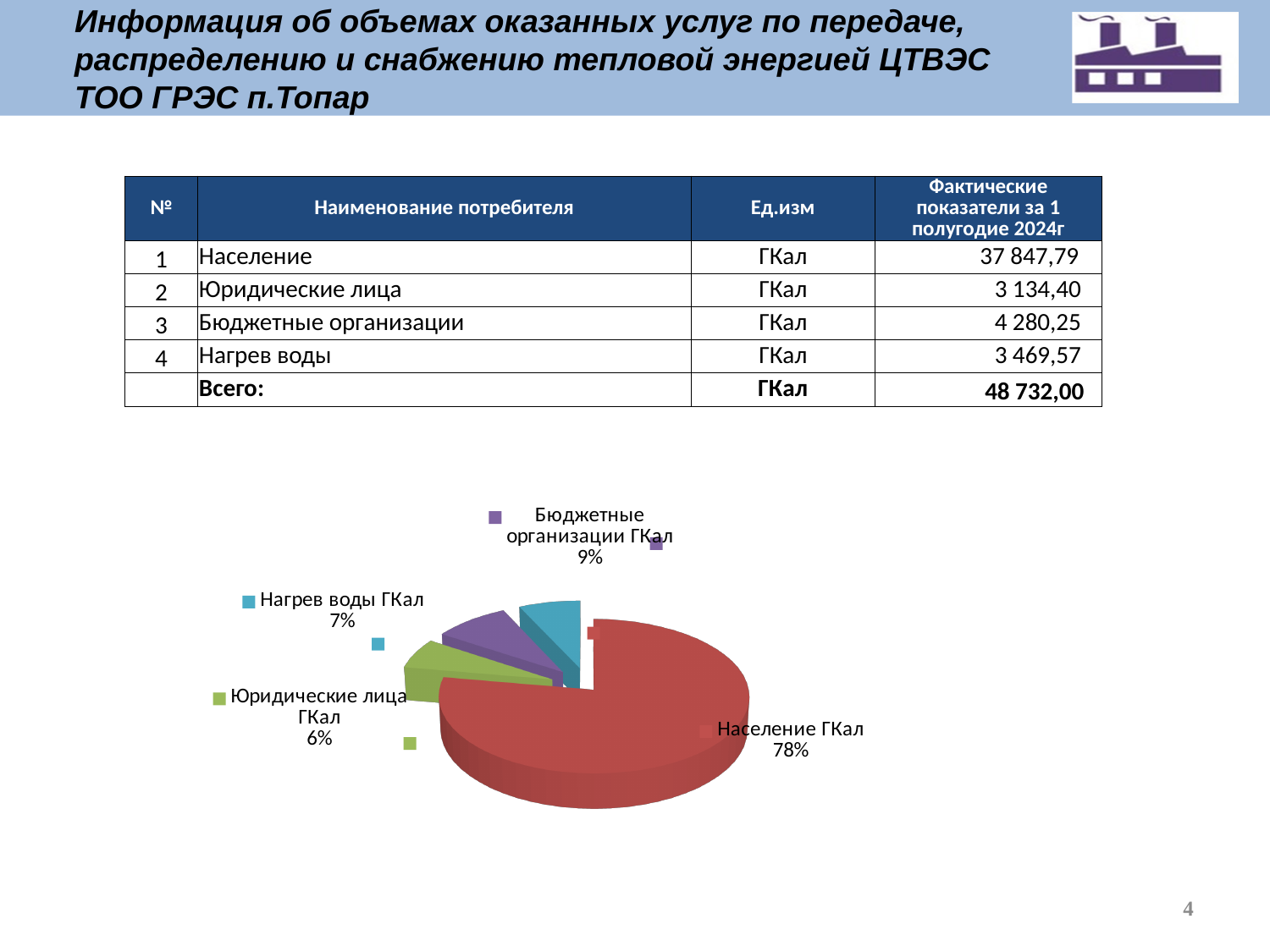
What kind of chart is shown on the slide? pie chart What share of the pie does Население ГКал have? 78% How many slices does the pie chart have? 4 What share of the pie does Нагрев воды ГКал have? 7% Is the share for Население ГКал greater or less than 50%? greater Which slice of the pie chart is the smallest? Юридические лица ГКал Which slice of the pie chart is the largest? Население ГКал What is the difference in percentage points between the Население ГКал slice and the Бюджетные организации ГКал slice? 69 What share of the pie does Юридические лица ГКал have? 6% Which is larger in the pie chart: Бюджетные организации ГКал or Нагрев воды ГКал? Бюджетные организации ГКал What colour is the Население ГКал slice in the pie chart? red